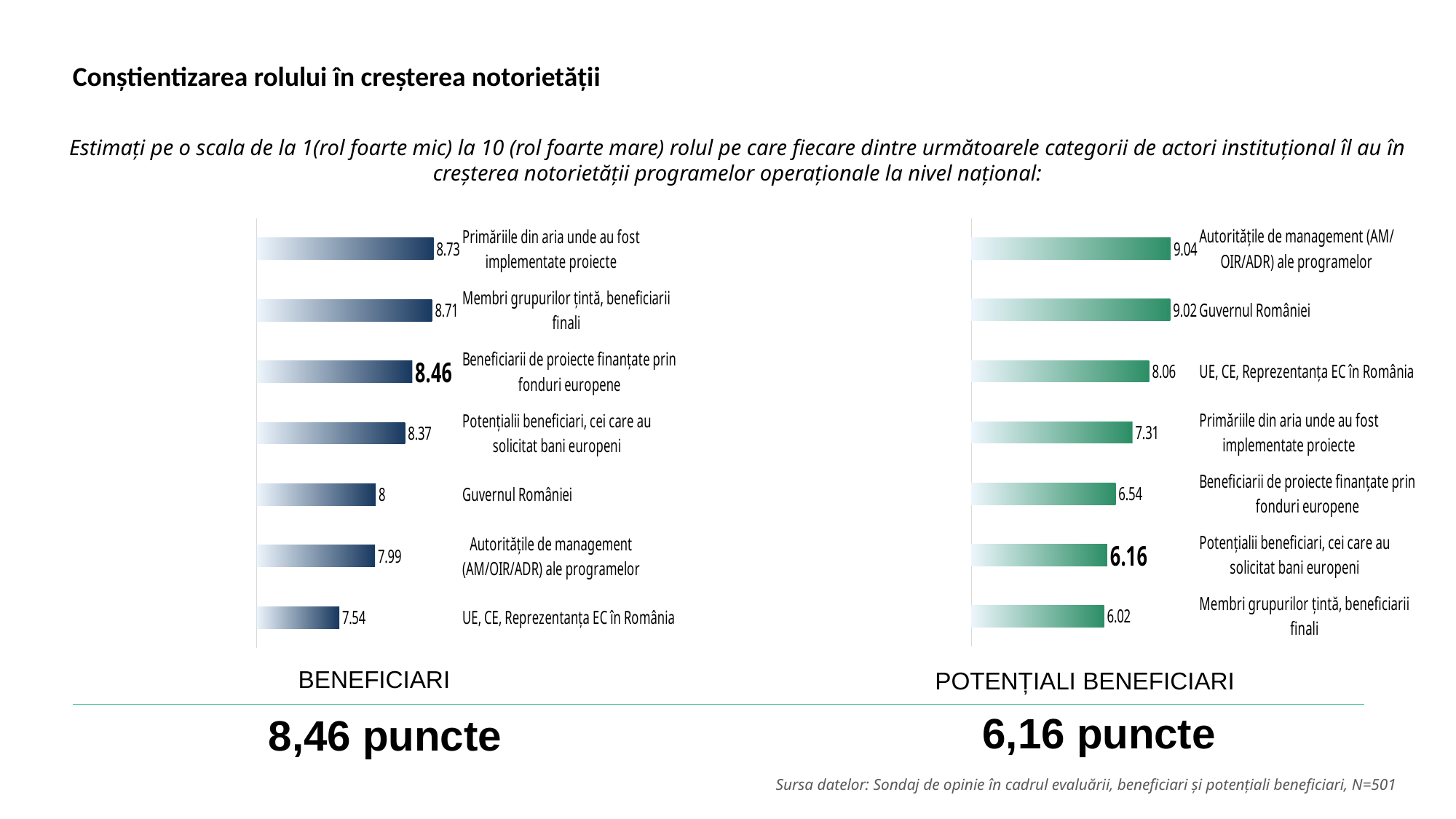
What colour are the bars in the BENEFICIARI chart? Dark blue In the POTENȚIALI BENEFICIARI chart, what is the difference between the values for Autoritățile de management (AM/OIR/ADR) ale programelor and Potențialii beneficiari, cei care au solicitat bani europeni? 2.88 In the POTENȚIALI BENEFICIARI chart, what value is shown for Primăriile din aria unde au fost implementate proiecte? 7.31 In the POTENȚIALI BENEFICIARI chart, which category has the lowest value? Membri grupurilor țintă, beneficiarii finali In the POTENȚIALI BENEFICIARI chart, what value is shown for Guvernul României? 9.02 In the BENEFICIARI chart, what value is shown for UE, CE, Reprezentanța EC în România? 7.54 How many categories are shown in the BENEFICIARI chart? 7 In the BENEFICIARI chart, which category has the highest value? Primăriile din aria unde au fost implementate proiecte In the BENEFICIARI chart, what is the difference between the values for Primăriile din aria unde au fost implementate proiecte and UE, CE, Reprezentanța EC în România? 1.19 In the BENEFICIARI chart, what value is shown for Guvernul României? 8 What kind of chart is the POTENȚIALI BENEFICIARI chart? Bar chart In the POTENȚIALI BENEFICIARI chart, which is larger: the value for UE, CE, Reprezentanța EC în România or the value for Beneficiarii de proiecte finanțate prin fonduri europene? UE, CE, Reprezentanța EC în România